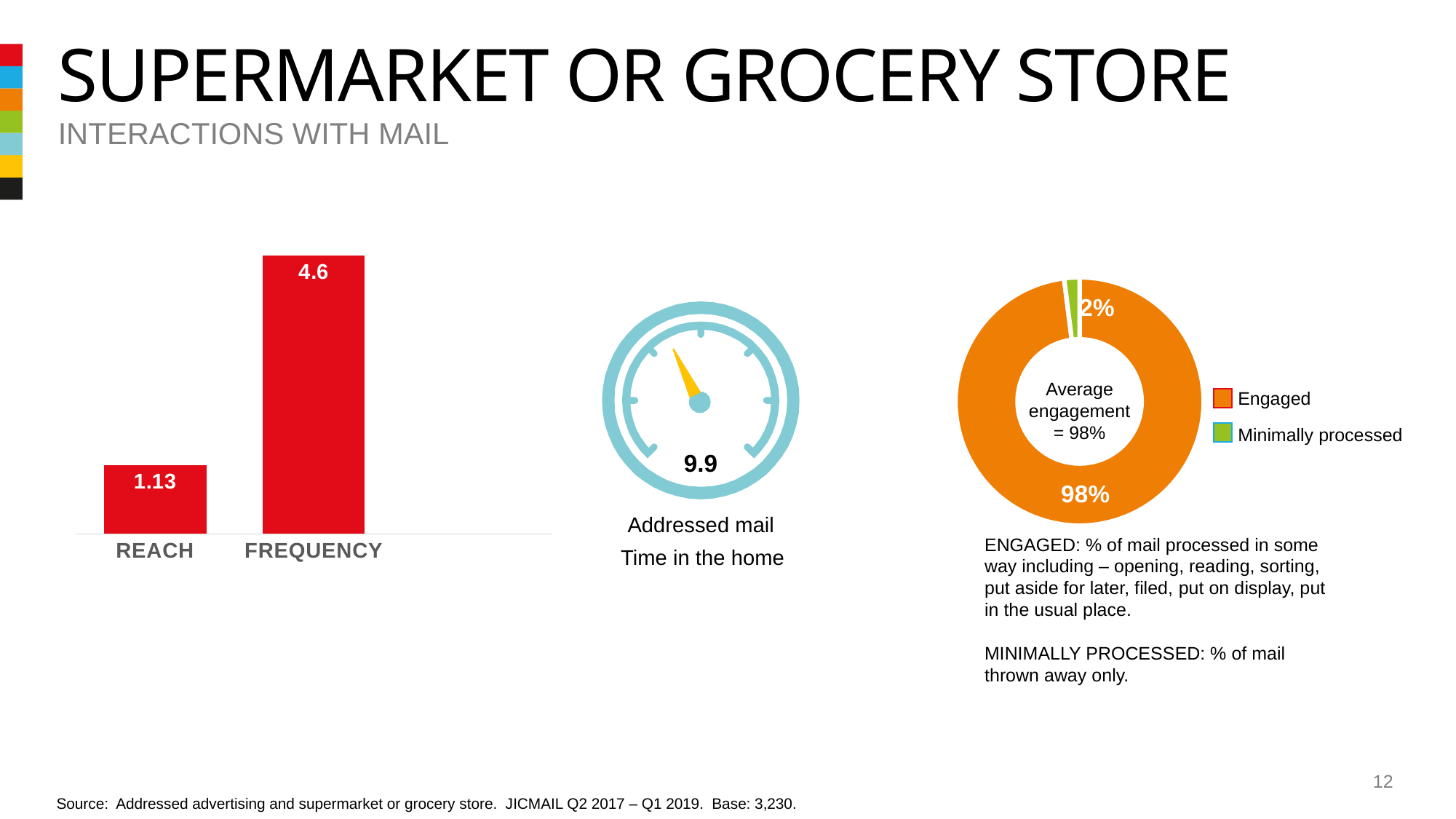
In the donut chart on the right, what share of mail is Engaged? 98% In the donut chart on the right, which segment is larger, Engaged or Minimally processed? Engaged In the bar chart on the left, what is the value for FREQUENCY? 4.6 In the bar chart on the left, which category has the higher value? FREQUENCY What kind of chart is shown on the left of the slide? Bar chart In the bar chart on the left, how many categories are shown? 2 In the bar chart on the left, what is the difference between the FREQUENCY and REACH values? 3.47 In the bar chart on the left, what is the value for REACH? 1.13 In the donut chart on the right, what colour is the Engaged segment? Orange In the bar chart on the left, which category has the lower value? REACH In the donut chart on the right, what share of mail is Minimally processed? 2% How many entries does the legend of the donut chart on the right list? 2